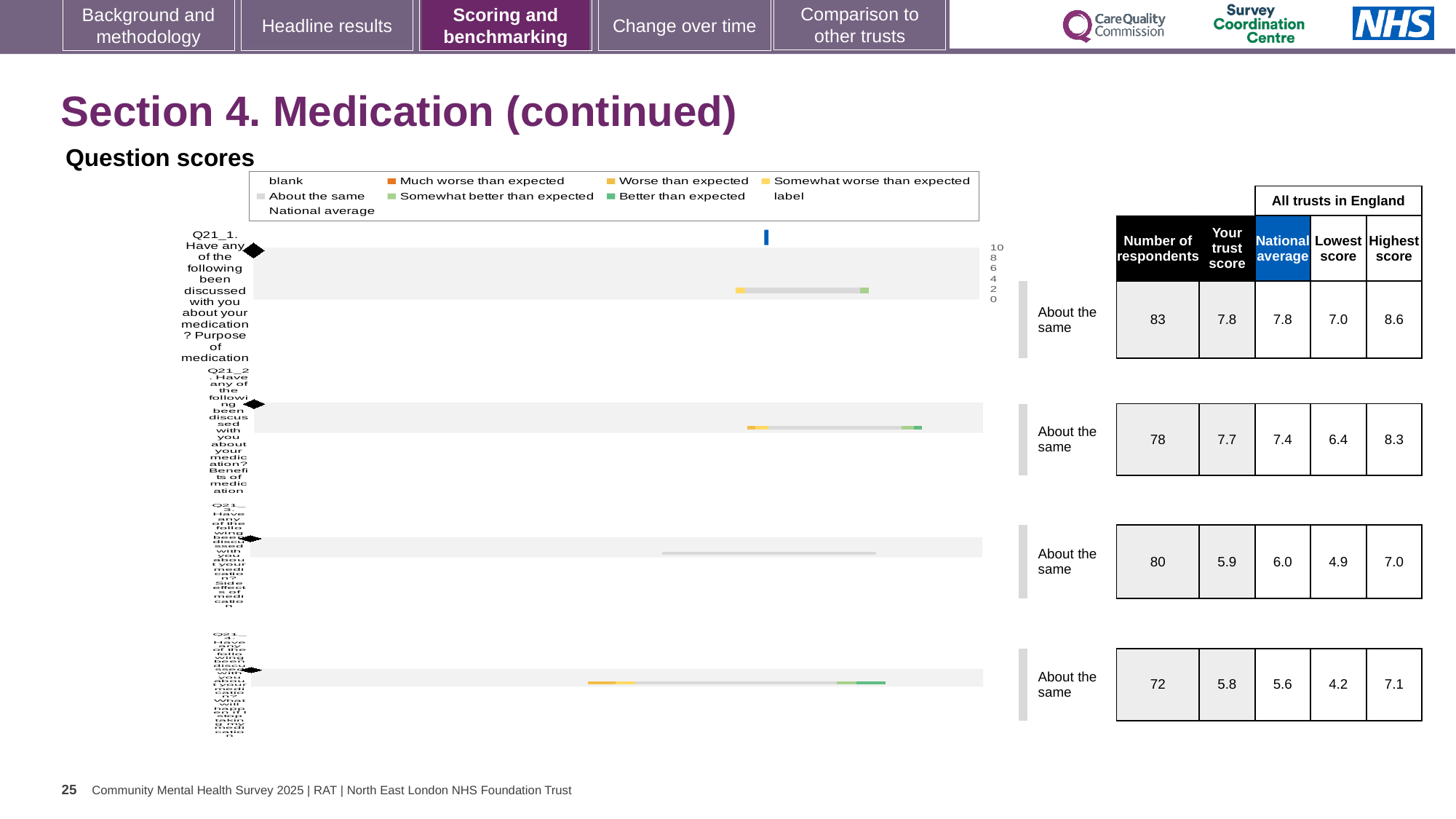
What is the national average for Q21_2 (Benefits of medication) in the table beside the chart? 7.4 What is the trust's score for Q21_1 (Purpose of medication) in the table beside the chart? 7.8 What is the lowest score across all trusts in England for Q21_4 in the table beside the chart? 4.2 What benchmark category is shown next to each of the four bars in the chart? About the same According to the table beside the chart, how many respondents answered Q21_1 (Purpose of medication)? 83 How many questions (bars) are plotted in the chart? 4 For Q21_3, which is larger: the trust's score or the national average? the national average What kind of chart is shown under 'Question scores'? bar chart By how much does the trust's score for Q21_2 exceed the national average for Q21_2? 0.3 What is the highest score across all trusts in England for Q21_3 (Side effects of medication)? 7.0 Which question has the highest 'Your trust score' in the table beside the chart? Q21_1 Which question has the lowest 'Your trust score' in the table beside the chart? Q21_4